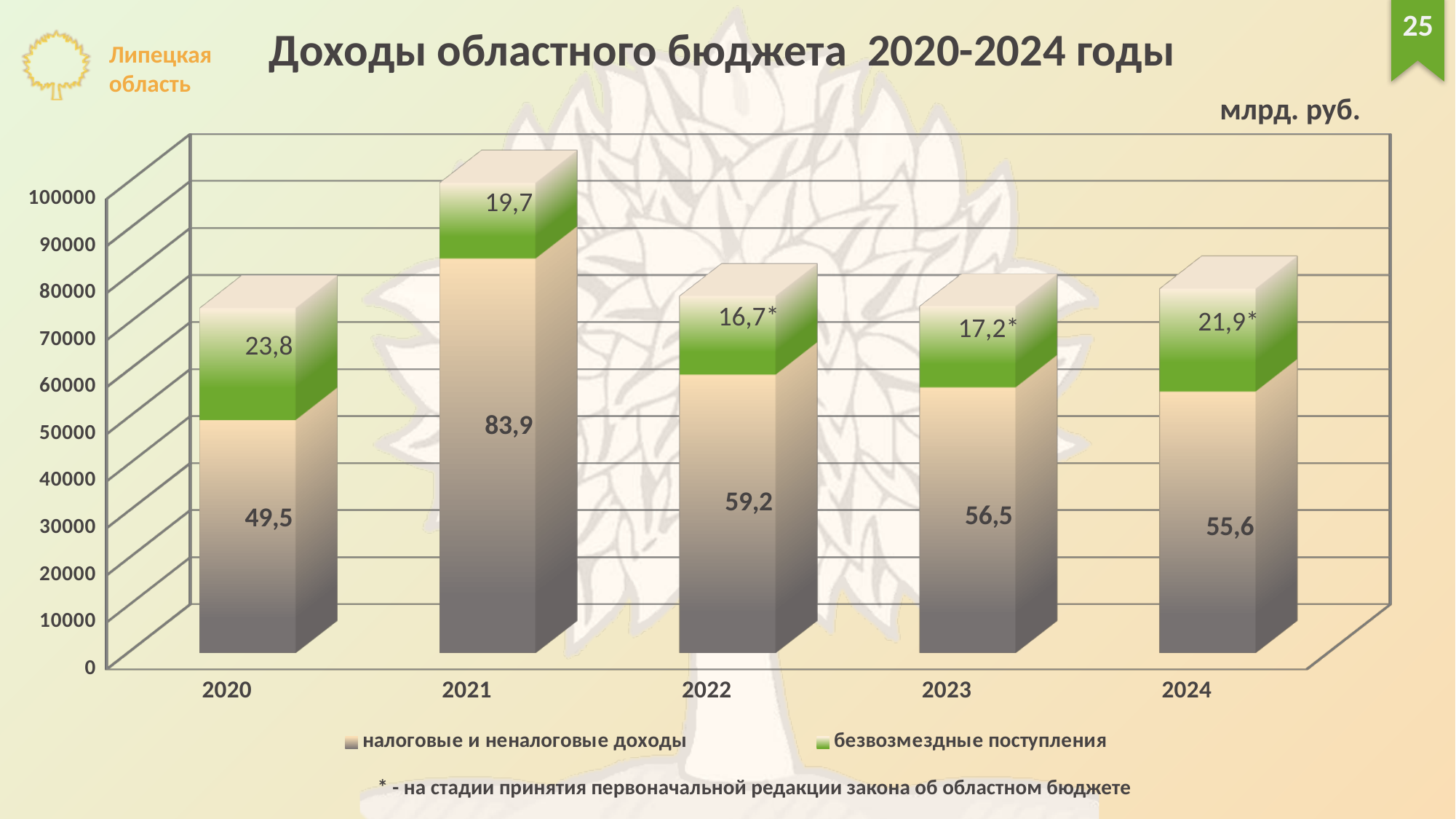
What is the difference between налоговые и неналоговые доходы in 2021 and in 2020? 34,4 What is the value of налоговые и неналоговые доходы for 2024? 55,6 In which year is налоговые и неналоговые доходы the highest? 2021 How many years are shown on the x axis? 5 How many series does the legend list? 2 Which is larger: налоговые и неналоговые доходы in 2022 or in 2023? 2022 What is the total of the stacked bar for 2021? 103,6 What is the value of безвозмездные поступления for 2020? 23,8 What kind of chart is shown on the slide? Stacked bar chart In which year is безвозмездные поступления the lowest? 2022 What is the value of налоговые и неналоговые доходы for 2021? 83,9 What is the value of безвозмездные поступления for 2022? 16,7